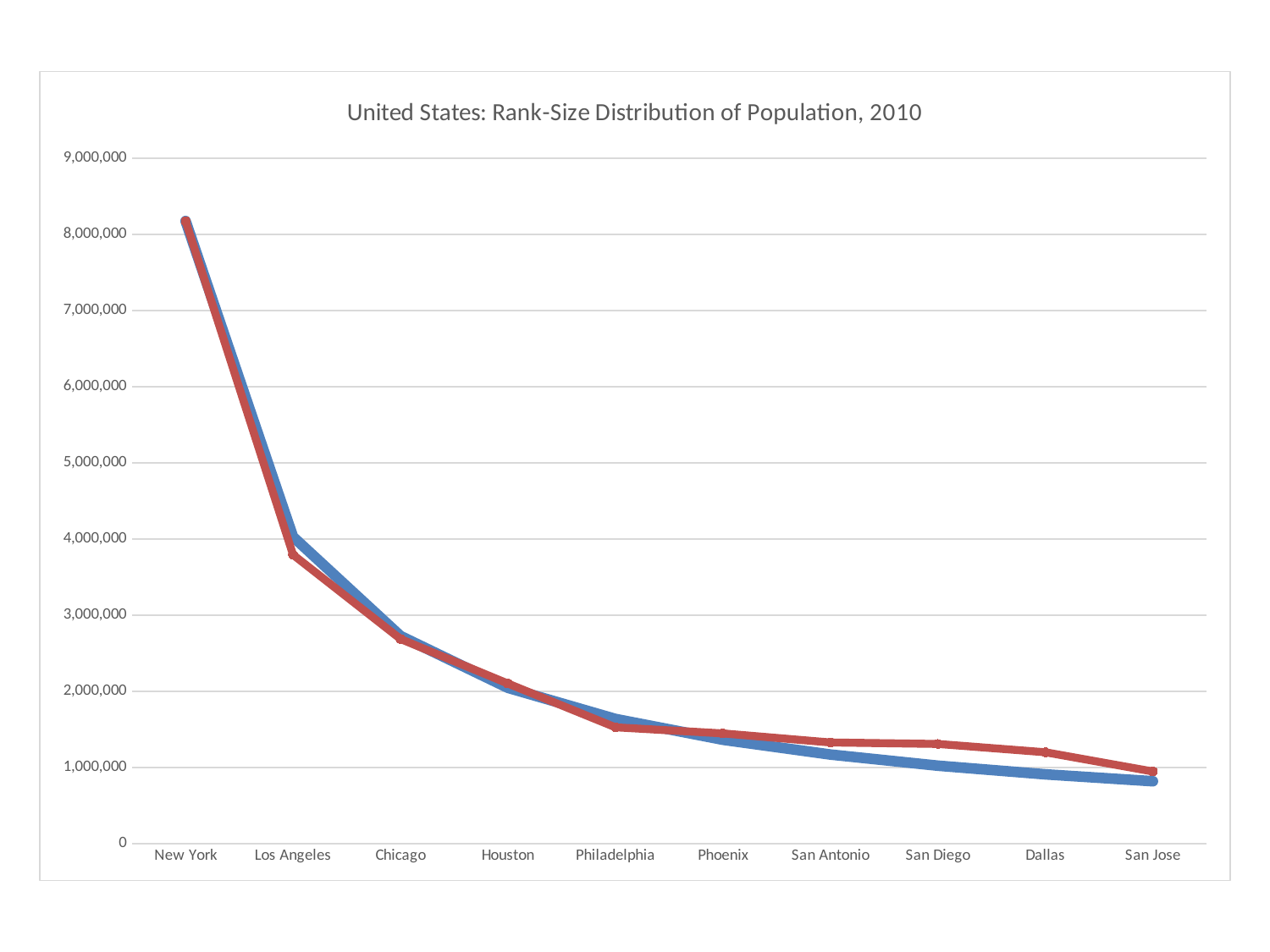
What kind of chart is shown on the slide? line chart Which city has the lowest value on the blue line? San Jose How many cities are shown on the x axis of the chart? 10 Is the value for Philadelphia greater or less than 1,000,000? greater How many lines are plotted on the chart? 2 Is the value for New York greater or less than 7,000,000? greater At San Diego, which line has the larger value, the red line or the blue line? the red line Is the value of the blue line for San Jose greater or less than 1,000,000? less Which city has the highest value on the chart? New York What is the title of the chart? United States: Rank-Size Distribution of Population, 2010 Do the values rise or fall moving from New York to San Jose along the x axis? fall